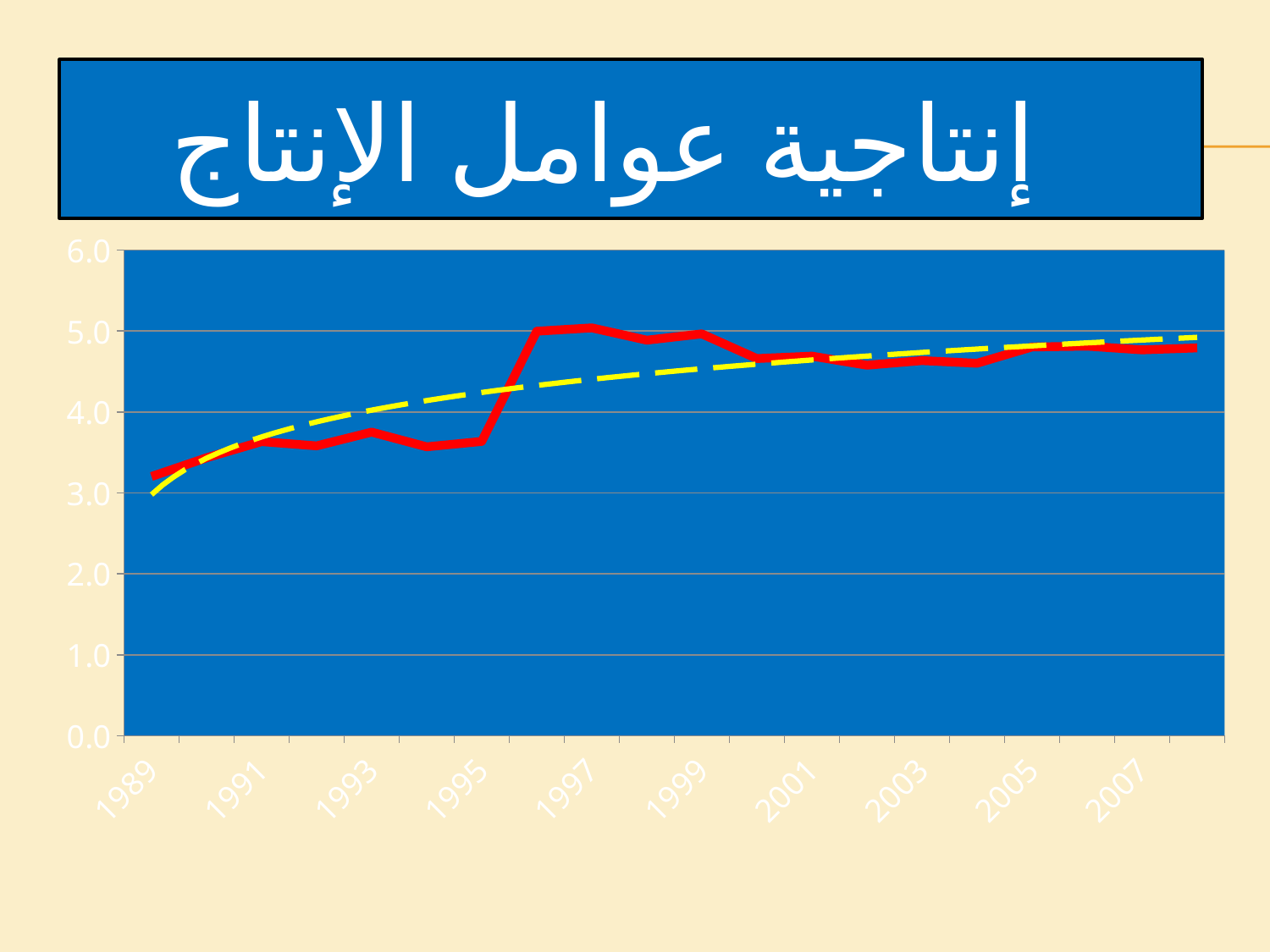
Is the value of the red line for 1997 greater or less than 4.0? greater How many year labels are shown on the x axis? 10 What colour is the dashed trend line on the chart? yellow Is the value of the red line for 2001 greater or less than 4.0? greater Which year has the larger value on the red line, 1995 or 1997? 1997 Is the value of the red line for 2007 greater or less than 5.0? less Do the values of the red line generally rise or fall from 1989 to 2007? rise Which year has the lowest value on the red line? 1989 What is the title of the chart? إنتاجية عوامل الإنتاج What kind of chart is shown on the slide? line chart